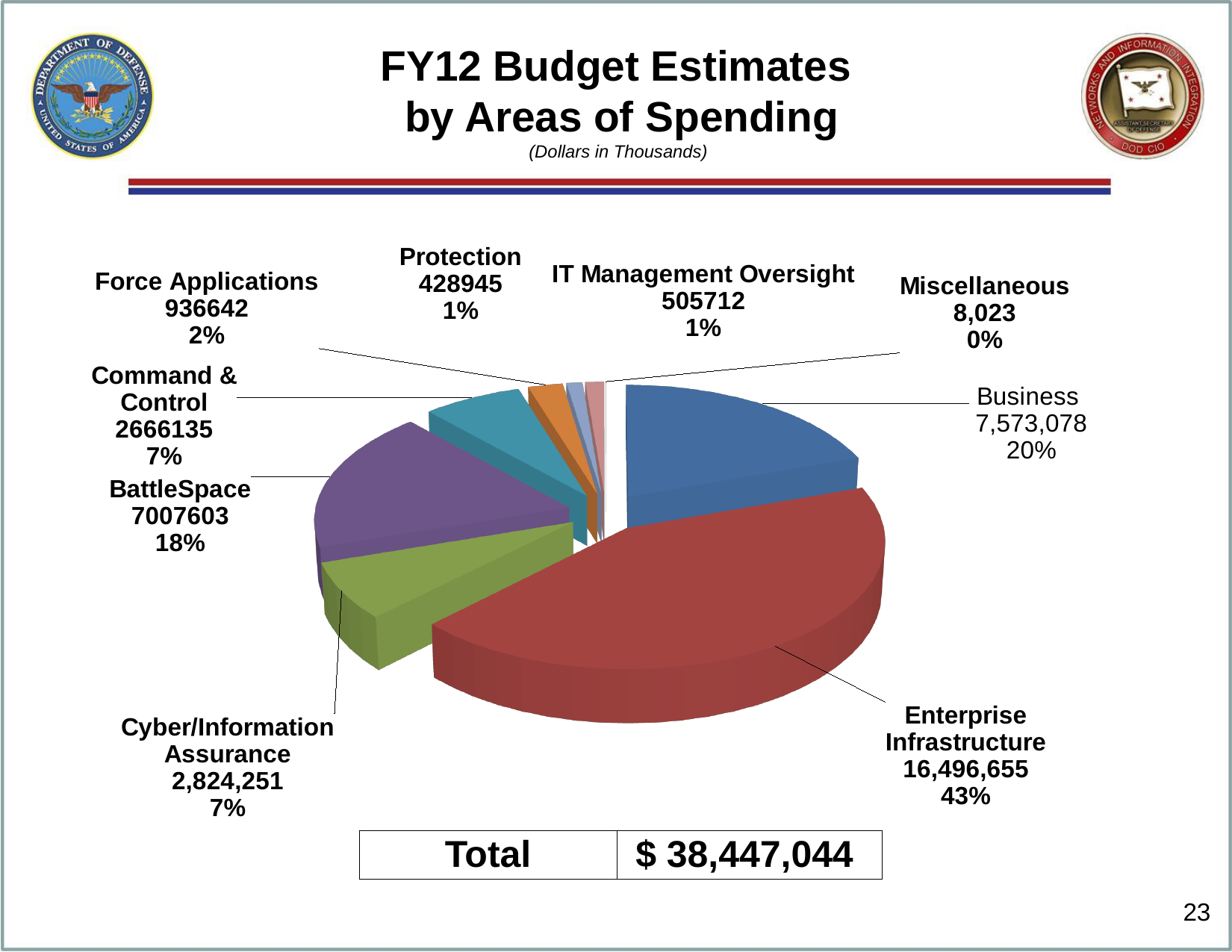
Which area of spending has the smallest value? Miscellaneous What share of the pie does Enterprise Infrastructure represent? 43% What total is shown below the pie chart? $ 38,447,044 What share of the pie does Business represent? 20% What is the value for Business? 7,573,078 What is the value for Enterprise Infrastructure? 16,496,655 Which area of spending has the largest value? Enterprise Infrastructure What is the value for BattleSpace? 7007603 Which is larger, the value for Business or the value for BattleSpace? Business What kind of chart is shown on the slide? pie chart How many areas of spending are shown in the pie chart? 9 What is the value for Cyber/Information Assurance? 2,824,251